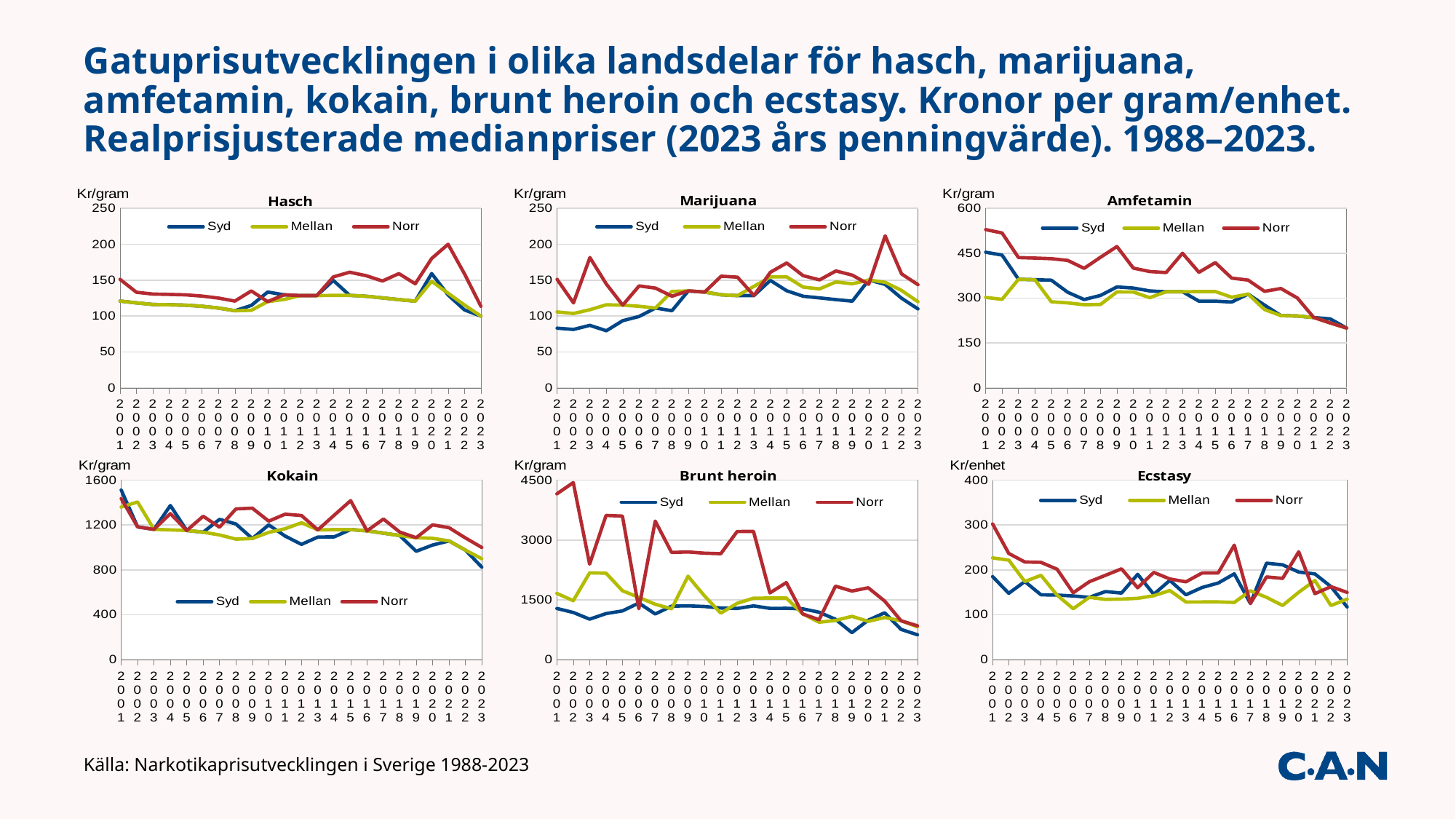
How many years (data points per series) are plotted on the x axis of the Marijuana chart? 23 How many series does the legend of the Kokain chart list? 3 In the Amfetamin chart, does the Norr series generally rise or fall from 2001 to 2023? fall In the Amfetamin chart, is the value for Norr in 2001 greater or less than 450? greater What kind of chart is the Hasch chart? line chart In the Hasch chart, is the value for Norr in 2021 greater or less than 150? greater In the Brunt heroin chart, which series has the highest value in 2002? Norr In the Kokain chart, is the value for Syd in 2023 greater or less than 1200? less In the Ecstasy chart, which series has the lowest value in 2001? Syd What unit is shown on the y axis of the Ecstasy chart? Kr/enhet